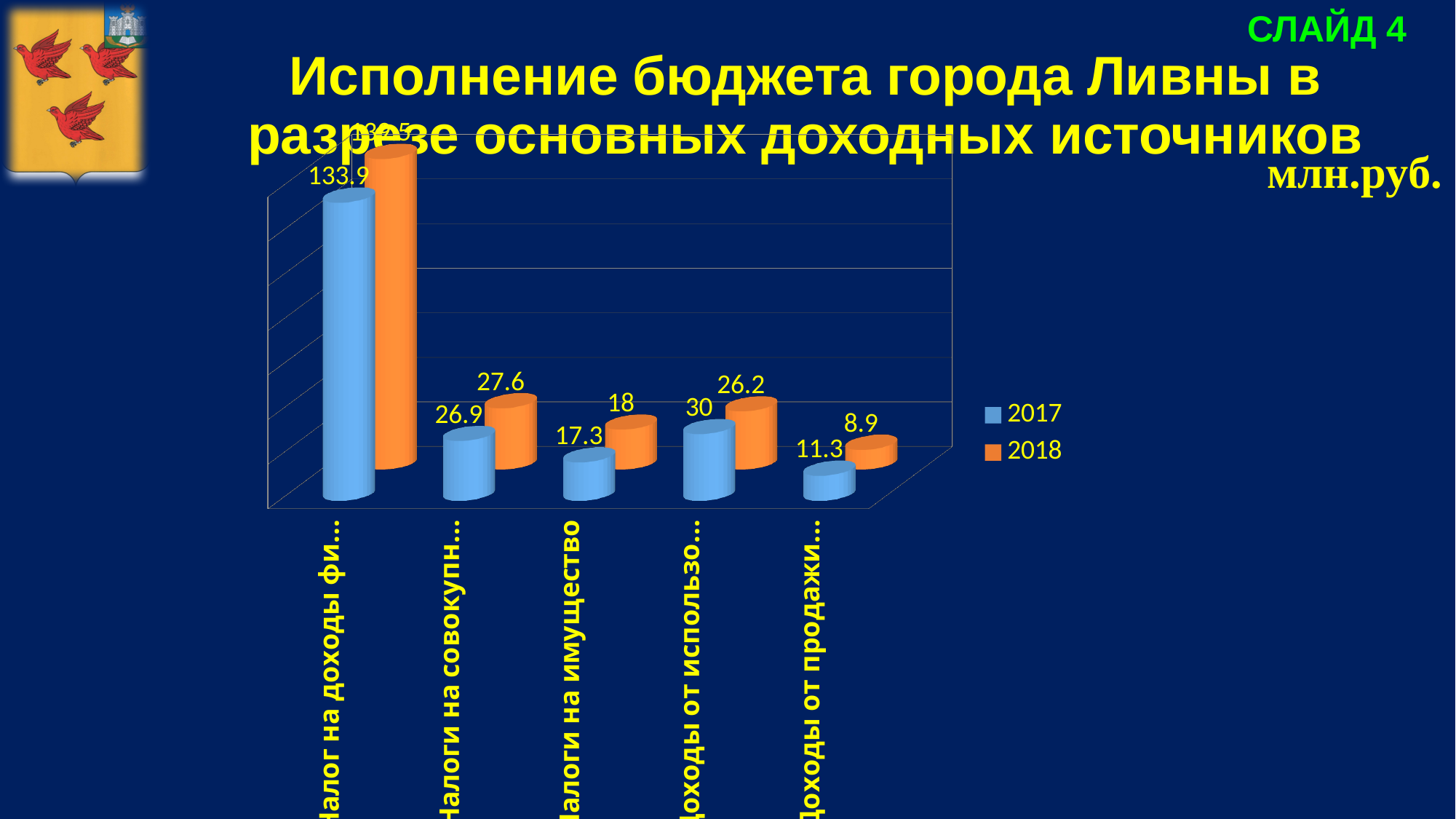
How many series does the legend list? 2 What is the difference between the 2017 and 2018 values for the last category (Доходы от продажи...)? 2.4 By how much does the 2018 value for Налоги на имущество exceed the 2017 value? 0.7 Which category has the lowest 2018 value? Доходы от продажи... (the last category) What kind of chart is shown on the slide? Bar chart How many categories are shown on the x axis? 5 For the fourth category (Доходы от использо...), which year has the larger value, 2017 or 2018? 2017 What is the 2018 value for Налоги на имущество? 18 What is the 2017 value for the fourth category (Доходы от использо...)? 30 What is the 2017 value for Налоги на имущество? 17.3 What is the 2018 value for the second category (Налоги на совокупн...)? 27.6 What is the 2018 value for the last category (Доходы от продажи...)? 8.9